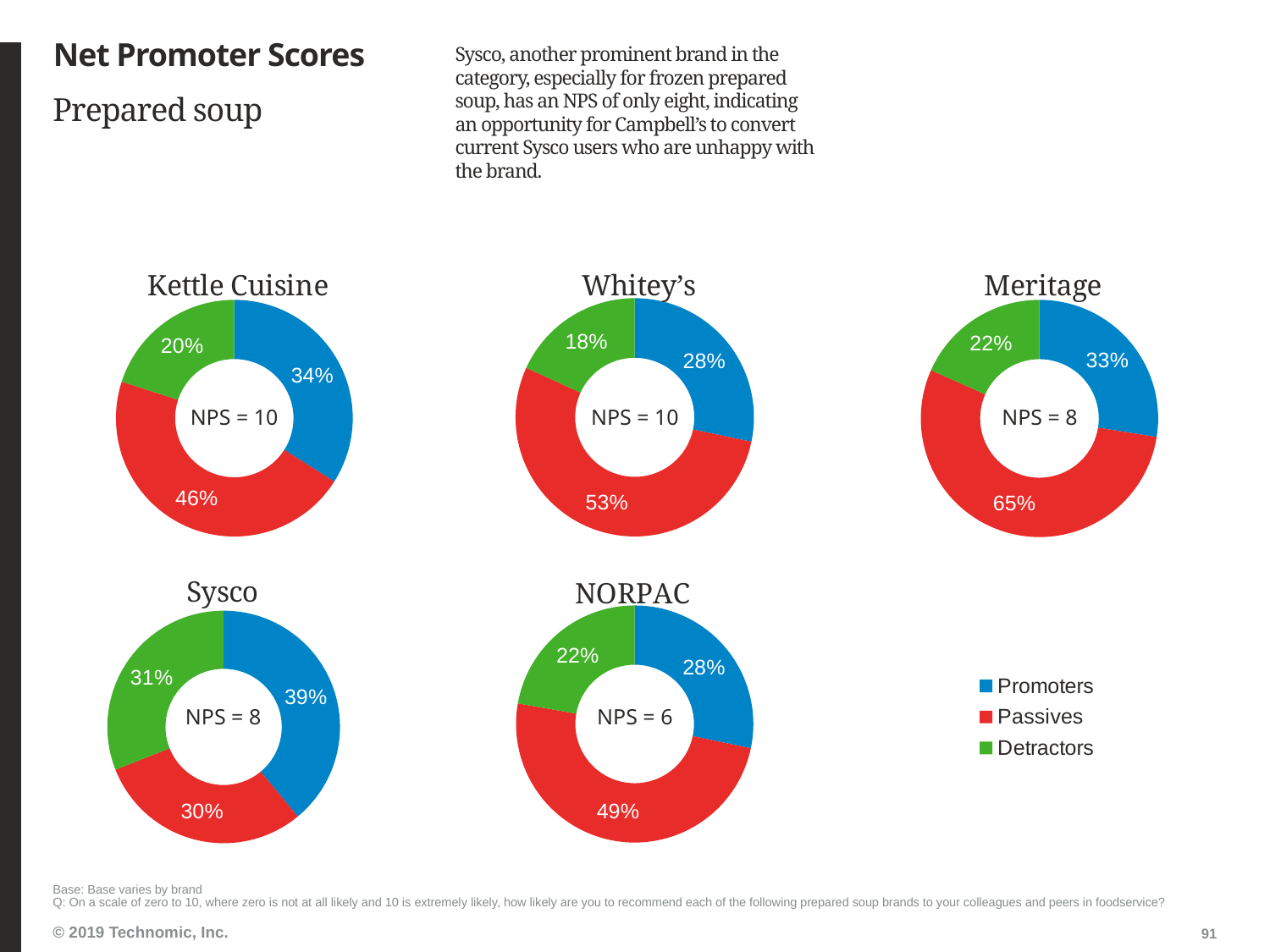
How many series does the legend list? 3 In the Sysco chart, what percentage are Promoters? 39% In the Meritage chart, which segment is the largest? Passives What type of chart is used for each brand on the slide? Donut (pie) chart In the Whitey's chart, what percentage are Passives? 53% In the Whitey's chart, which segment is the smallest? Detractors Which is larger in the NORPAC chart: Promoters or Detractors? Promoters How many donut charts are shown on the slide? 5 In the Kettle Cuisine chart, what percentage are Promoters? 34% In the Sysco chart, what is the difference between the Promoters and Passives percentages? 9% What is the NPS shown in the centre of the NORPAC chart? NPS = 6 In the Meritage chart, what percentage are Detractors? 22%